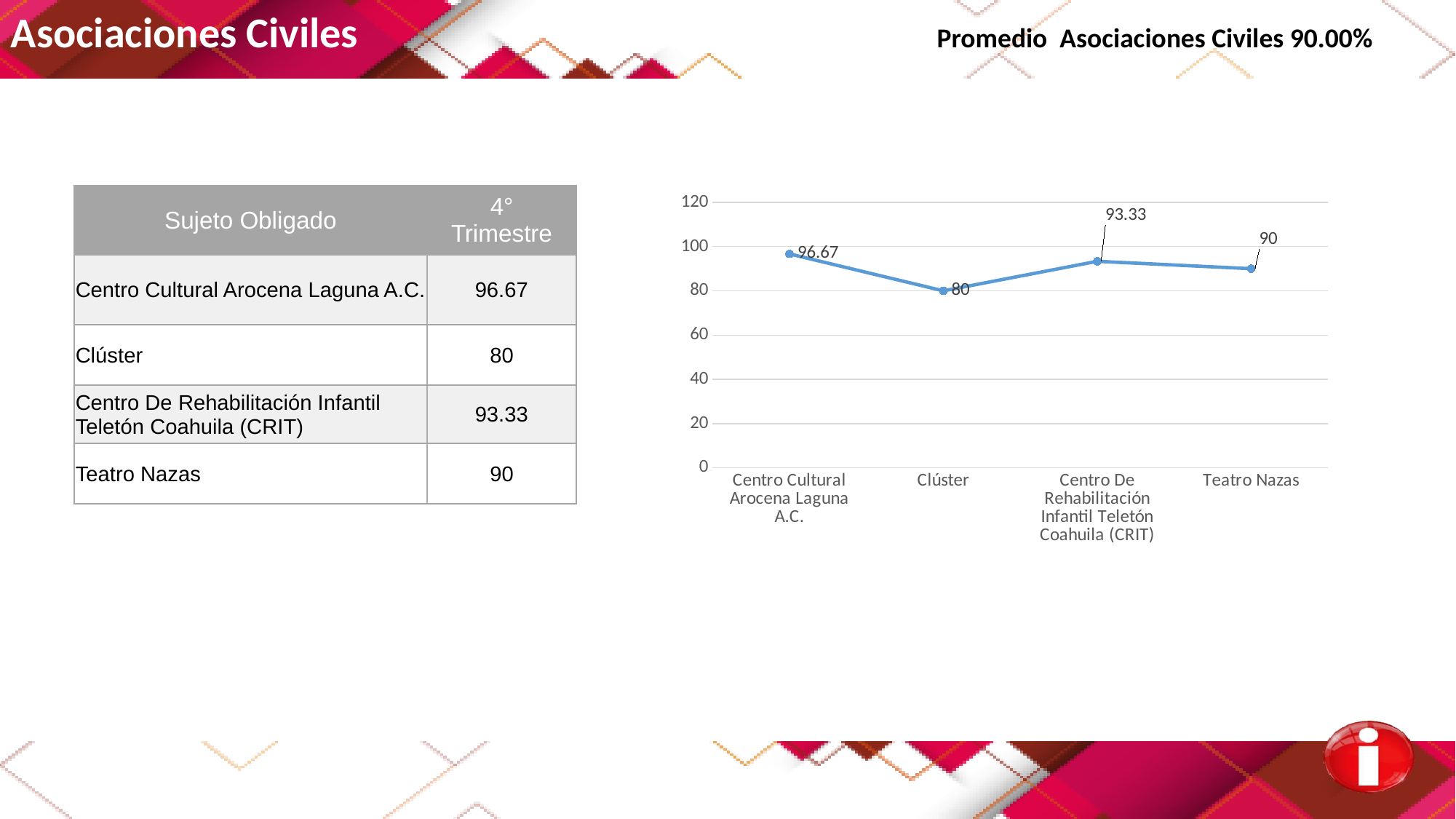
What is the value for Teatro Nazas in the chart? 90 How many categories are plotted in the chart? 4 What is the value for Centro De Rehabilitación Infantil Teletón Coahuila (CRIT) in the chart? 93.33 What is the difference between the values for Centro Cultural Arocena Laguna A.C. and Clúster? 16.67 What is the highest value shown on the vertical axis of the chart? 120 What kind of chart is shown on the slide? line chart Is the value for Clúster greater or less than 100? less Which category has the lowest value in the chart? Clúster Which is larger, the value for Centro De Rehabilitación Infantil Teletón Coahuila (CRIT) or the value for Teatro Nazas? Centro De Rehabilitación Infantil Teletón Coahuila (CRIT) What is the value for Centro Cultural Arocena Laguna A.C. in the chart? 96.67 What is the value for Clúster in the chart? 80 Which category has the highest value in the chart? Centro Cultural Arocena Laguna A.C.